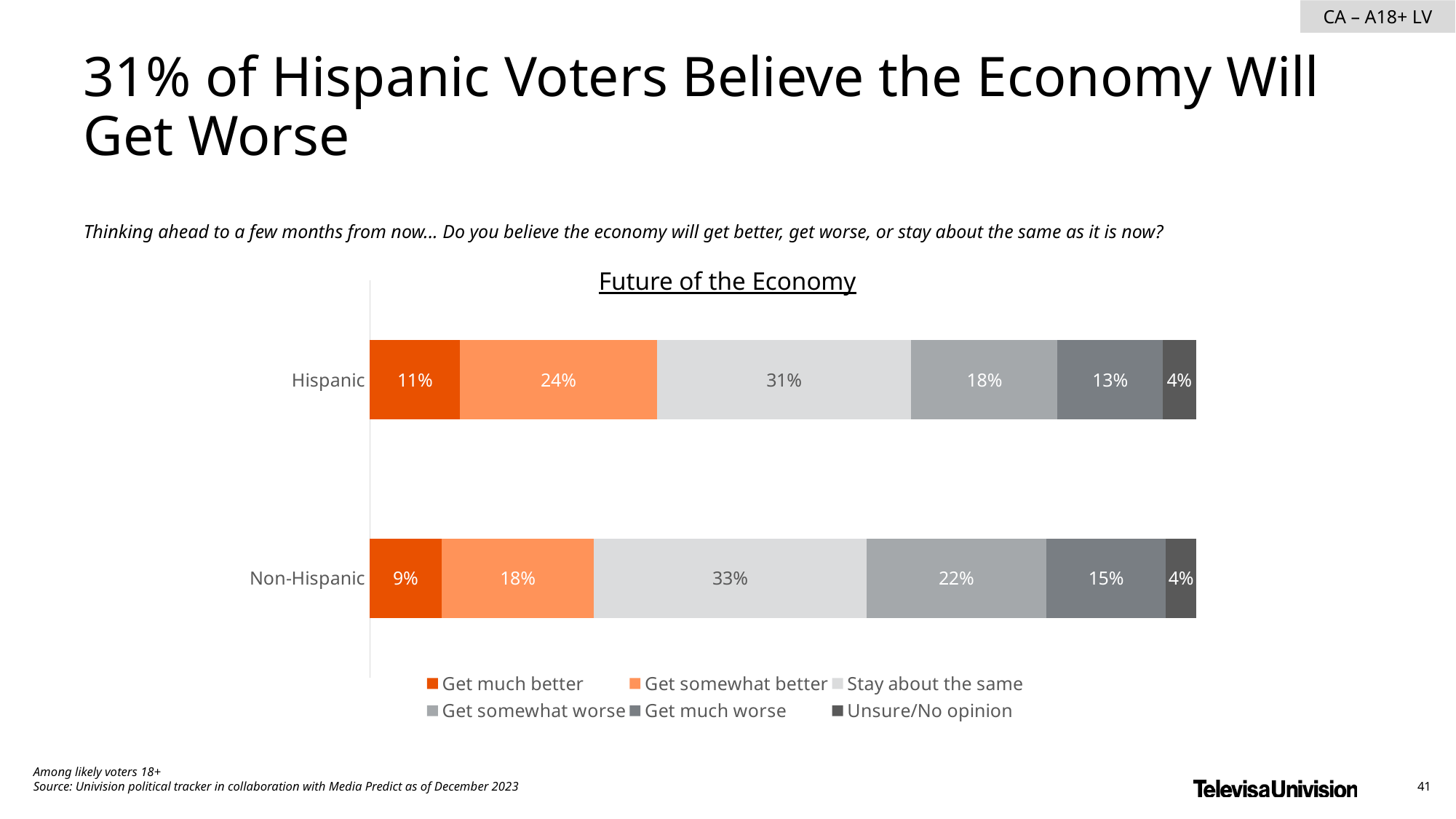
Which response category has the highest share among Hispanic voters? Stay about the same What percentage of Hispanic voters say the economy will get much better? 11% What is the difference between the Hispanic and Non-Hispanic shares for 'Get somewhat better'? 6 percentage points What percentage of Non-Hispanic voters say the economy will get much worse? 15% Which response category has the lowest share among Non-Hispanic voters? Unsure/No opinion What percentage of Non-Hispanic voters say the economy will get somewhat worse? 22% What percentage of Hispanic voters say the economy will stay about the same? 31% How many series does the legend list? 6 What kind of chart is shown on the slide? Stacked bar chart How many groups (categories) are shown on the chart? 2 Which group has a larger share saying the economy will get somewhat worse, Hispanic or Non-Hispanic? Non-Hispanic What is the title of the chart? Future of the Economy